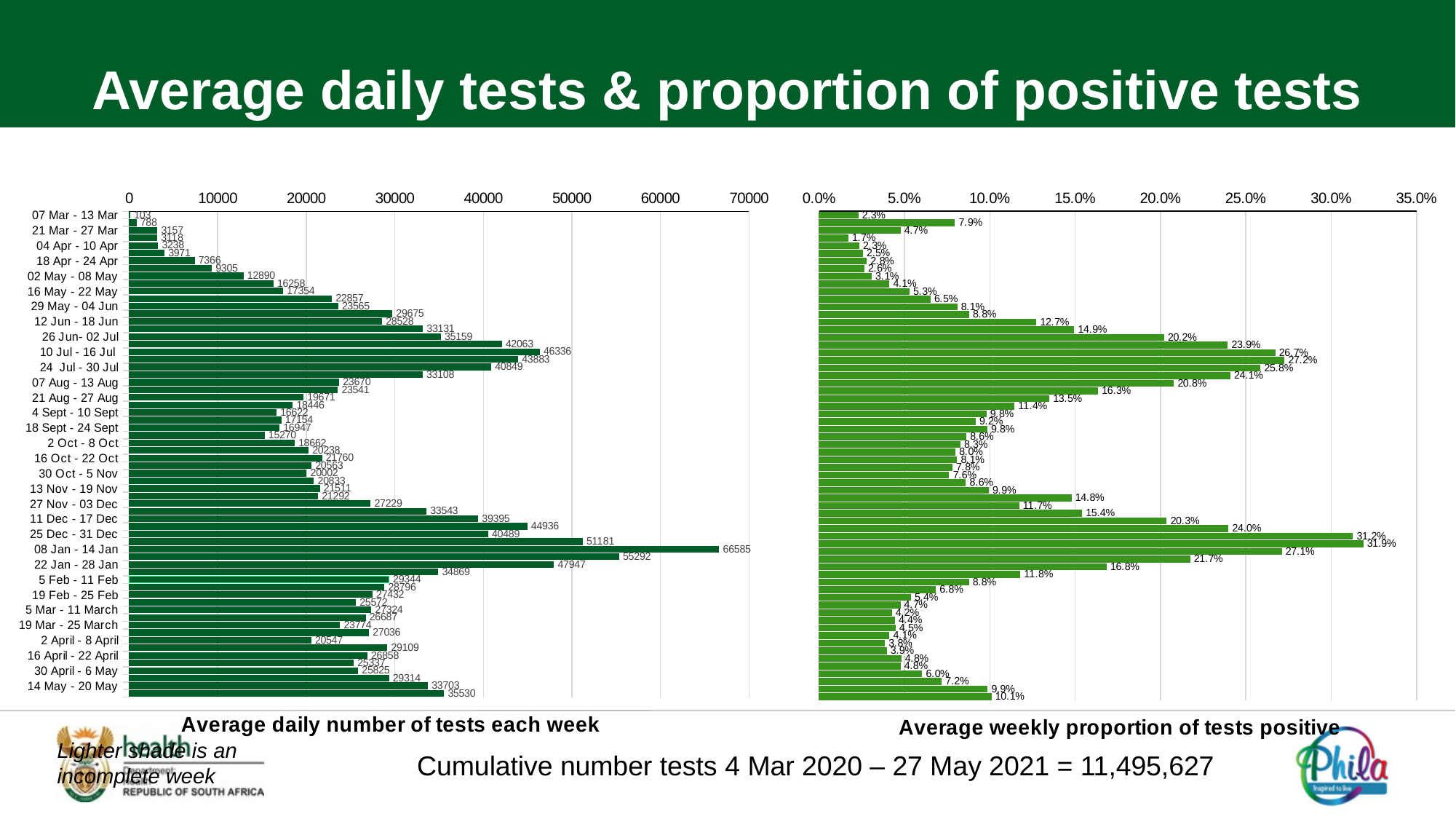
In the left chart 'Average daily number of tests each week', what is the value for 07 Mar - 13 Mar? 103 In the left chart 'Average daily number of tests each week', what is the value for 22 Jan - 28 Jan? 47947 In the left chart 'Average daily number of tests each week', what is the difference between the values for 08 Jan - 14 Jan and 22 Jan - 28 Jan? 18638 According to the note on the slide, what does a lighter shade bar indicate? an incomplete week In the right chart 'Average weekly proportion of tests positive', what is the lowest value shown? 1.7% In the right chart 'Average weekly proportion of tests positive', what is the highest value shown? 31.9% What kind of chart is the left chart, 'Average daily number of tests each week'? bar chart In the left chart 'Average daily number of tests each week', which week has the larger value: 10 Jul - 16 Jul or 08 Jan - 14 Jan? 08 Jan - 14 Jan In the left chart 'Average daily number of tests each week', is the value for 25 Dec - 31 Dec greater or less than 30000? greater In the left chart 'Average daily number of tests each week', what is the value for 10 Jul - 16 Jul? 46336 In the left chart 'Average daily number of tests each week', what is the value for 08 Jan - 14 Jan? 66585 In the left chart 'Average daily number of tests each week', what is the highest value shown? 66585